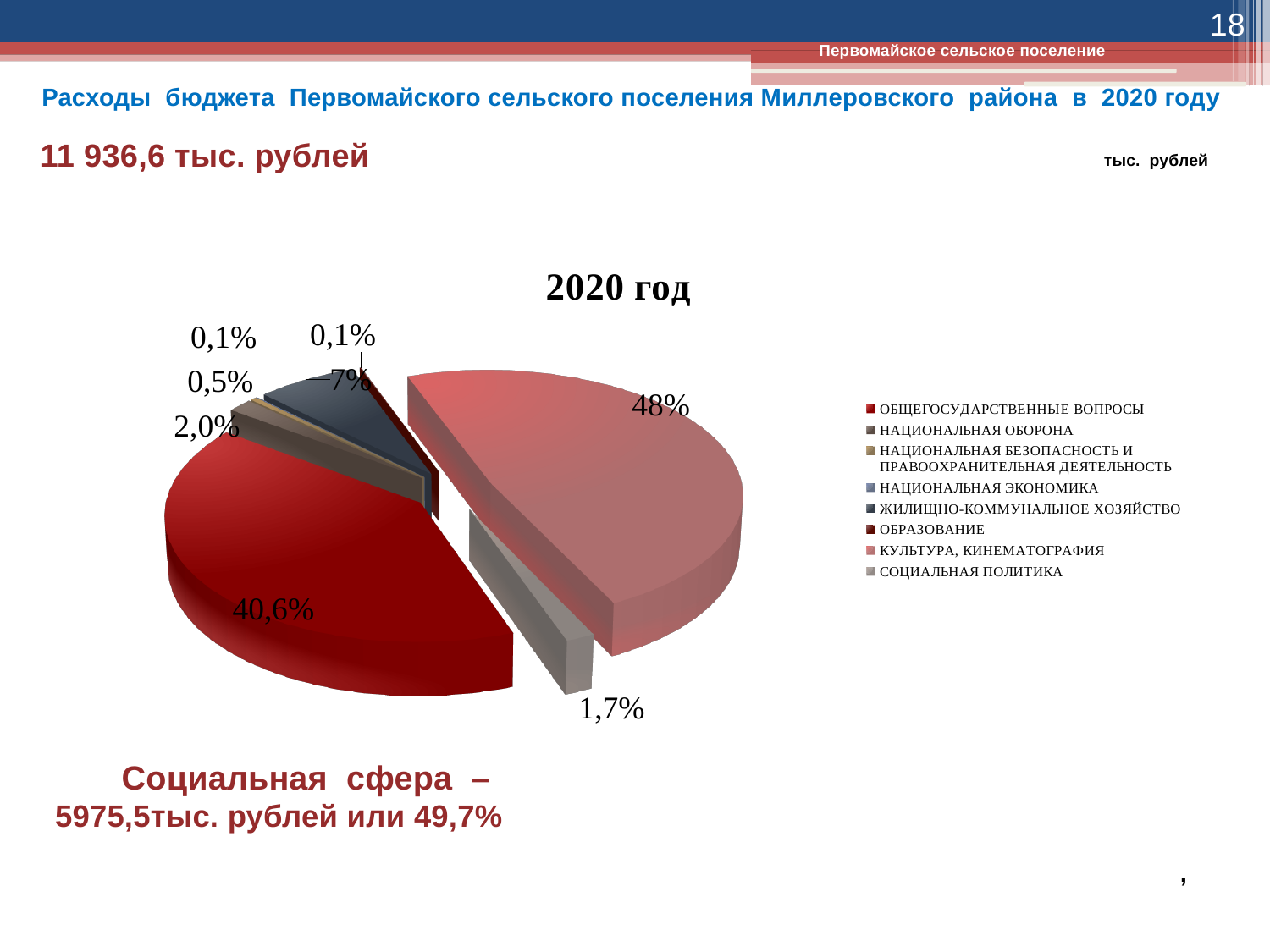
How many categories does the chart legend list? 8 What share of the pie does ОБЩЕГОСУДАРСТВЕННЫЕ ВОПРОСЫ have? 40,6% Which category has the largest slice of the pie chart? КУЛЬТУРА, КИНЕМАТОГРАФИЯ What kind of chart is shown on the slide? pie chart Which is larger: the slice labelled 48% or the slice labelled 40,6%? 48% What is the title of the chart? 2020 год What is the largest share shown on the pie chart? 48% What is the difference between the 48% slice and the 40,6% slice? 7,4% What share of the pie does СОЦИАЛЬНАЯ ПОЛИТИКА have? 1,7% What share of the pie does ЖИЛИЩНО-КОММУНАЛЬНОЕ ХОЗЯЙСТВО have? 7% What is the smallest share labelled on the pie chart? 0,1% What is the total budget expenditure stated on the slide for 2020? 11 936,6 тыс. рублей